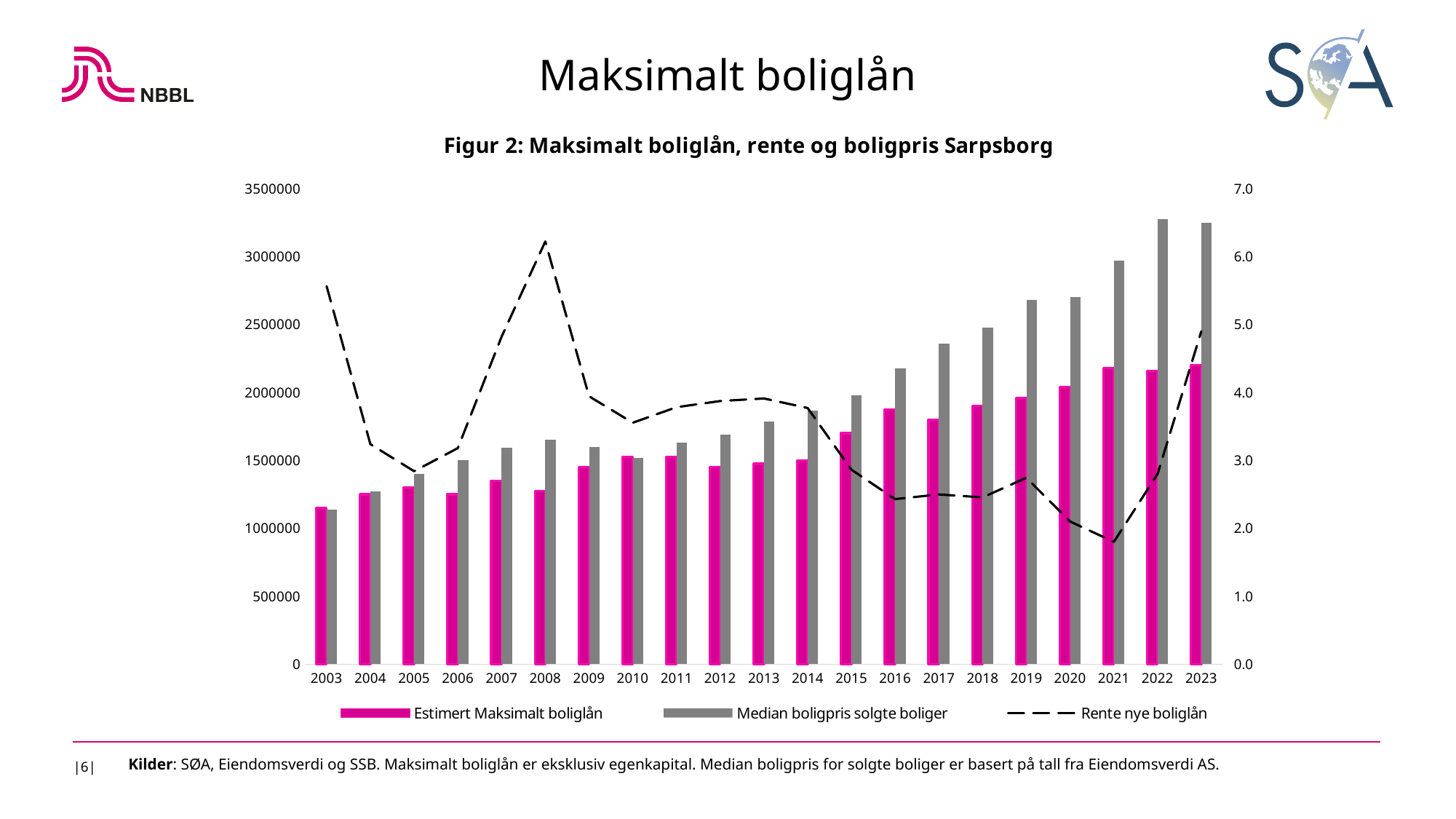
How many series does the legend list? 3 In which year is Estimert Maksimalt boliglån at its lowest? 2003 What kind of chart is shown on the slide? A combined bar and line chart What is the title of the figure on the slide? Figur 2: Maksimalt boliglån, rente og boligpris Sarpsborg In which year is Rente nye boliglån at its highest? 2008 In 2015, which is larger: Estimert Maksimalt boliglån or Median boligpris solgte boliger? Median boligpris solgte boliger Does Median boligpris solgte boliger rise or fall from 2014 to 2023? Rise How many years are shown on the x axis of the chart? 21 Is the value for Rente nye boliglån in 2003 greater or less than 5.0? greater Is the value for Median boligpris solgte boliger in 2022 greater or less than 3000000? greater Is the value for Estimert Maksimalt boliglån in 2023 greater or less than 2000000? greater In which year is Rente nye boliglån at its lowest? 2021